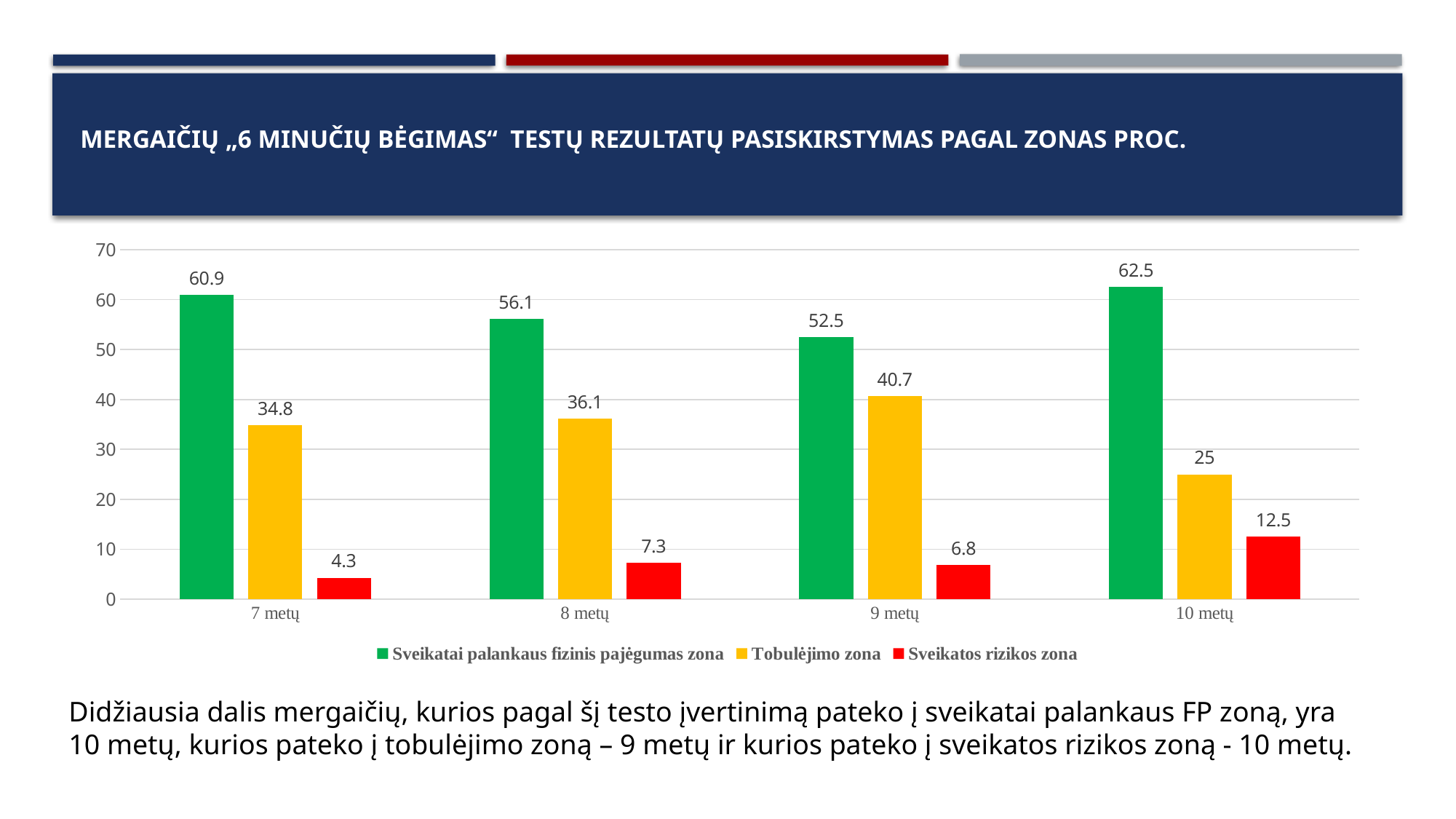
How many series does the legend list? 3 What is the difference between the "Tobulėjimo zona" values for 9 metų and 10 metų? 15.7 Which is larger: the "Sveikatai palankaus fizinis pajėgumas zona" value for 8 metų or for 9 metų? 8 metų What colour represents "Tobulėjimo zona" in the chart? Yellow What is the value for "Sveikatai palankaus fizinis pajėgumas zona" at 7 metų? 60.9 Do the "Sveikatos rizikos zona" values rise or fall from 9 metų to 10 metų? Rise Which age group has the lowest value for "Sveikatos rizikos zona"? 7 metų What is the value for "Tobulėjimo zona" at 9 metų? 40.7 How many age groups are shown on the x axis? 4 Which age group has the highest value for "Sveikatai palankaus fizinis pajėgumas zona"? 10 metų What is the value for "Sveikatos rizikos zona" at 10 metų? 12.5 What kind of chart is shown on the slide? Bar chart